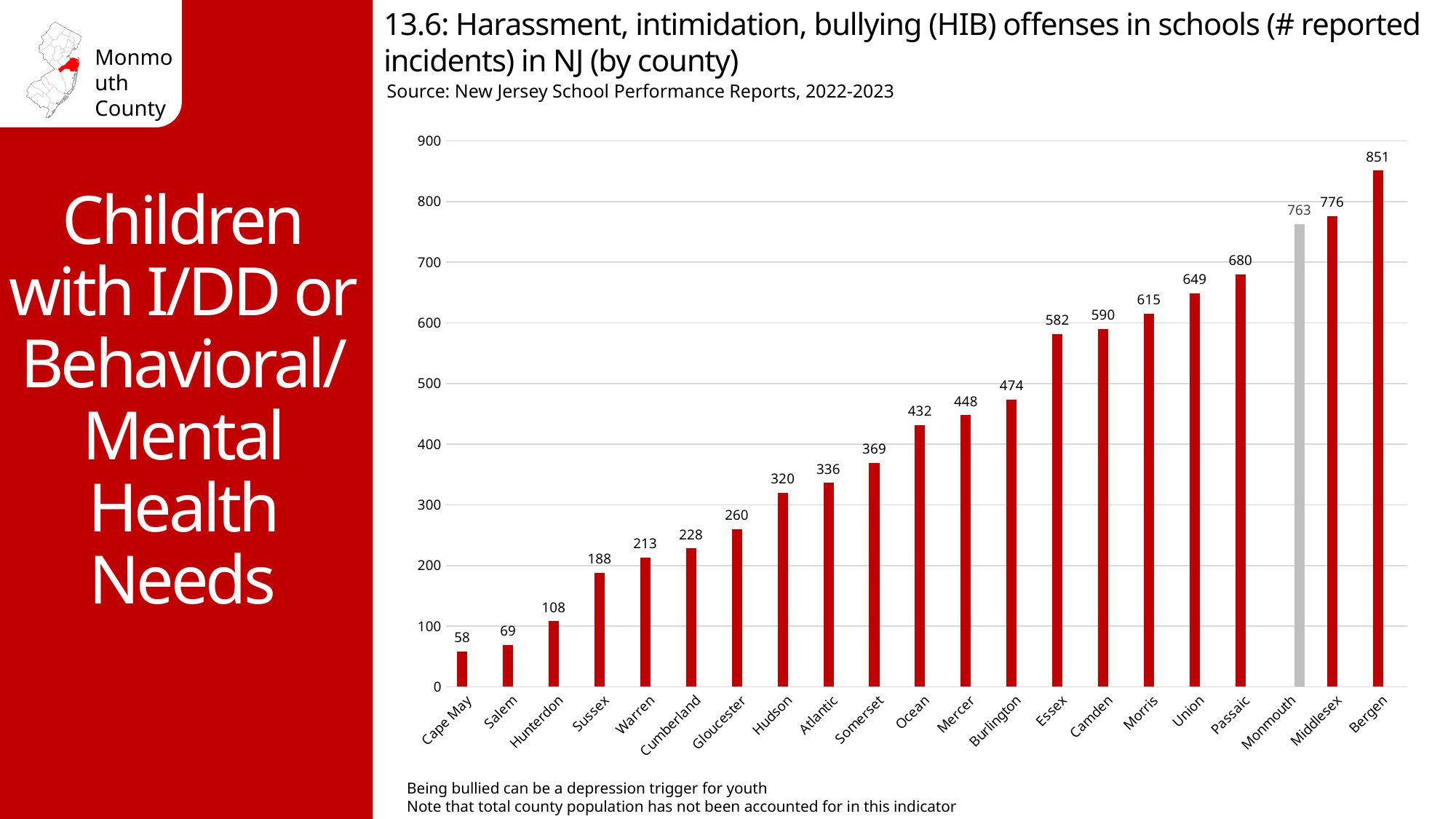
Is the value for Passaic greater or less than 700? less What is the number of reported HIB incidents for Hudson? 320 What is the difference in reported HIB incidents between Bergen and Monmouth? 88 Do the values rise or fall moving from left to right along the x axis? rise Which county has the lowest number of reported HIB incidents? Cape May Which county's bar is coloured grey instead of red? Monmouth What is the difference in reported HIB incidents between Essex and Camden? 8 How many HIB incidents were reported for Monmouth County? 763 What kind of chart is used to show the HIB incidents by county? bar chart Which county has the highest number of reported HIB incidents? Bergen Which county has more reported HIB incidents, Ocean or Burlington? Burlington How many counties are shown on the chart? 21